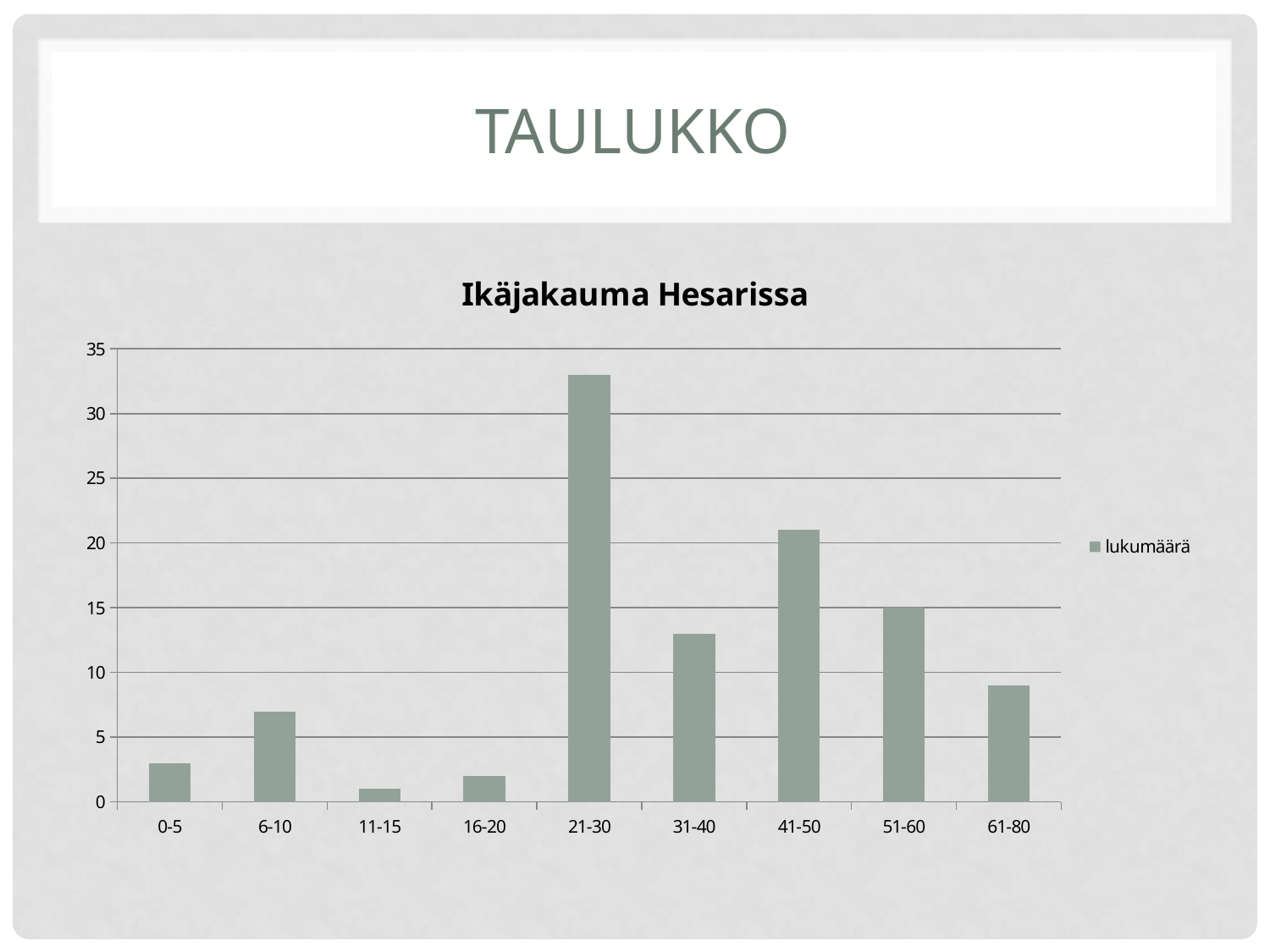
Which age category has the highest value? 21-30 What is the value for the 51-60 category? 15 Which age category has the lowest value? 11-15 How many series does the legend list? 1 What is the title of the chart? Ikäjakauma Hesarissa Is the value for 21-30 greater or less than 30? greater Is the value for 61-80 greater or less than 10? less Which has a larger value, 31-40 or 41-50? 41-50 What kind of chart is shown on the slide? bar chart How many age categories are shown on the x axis? 9 Which has a larger value, 0-5 or 6-10? 6-10 Is the value for 41-50 greater or less than 20? greater